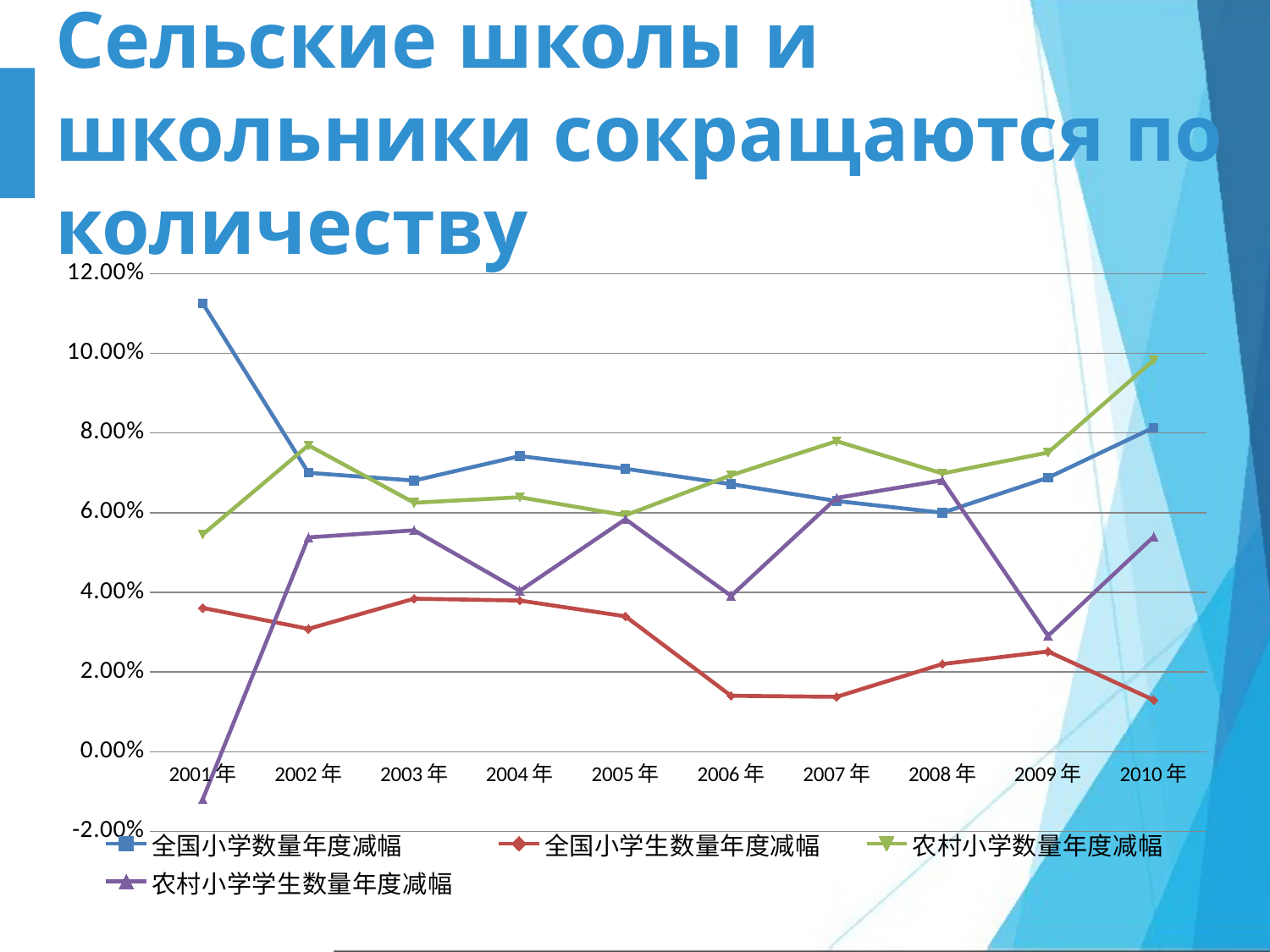
Which series has the highest value in 2001年? 全国小学数量年度减幅 In which year does the 农村小学学生数量年度减幅 series have its lowest value? 2001年 In which year does the 农村小学数量年度减幅 series reach its highest value? 2010年 How many years are plotted along the x axis of the chart? 10 In 2010年, which is larger: 农村小学数量年度减幅 or 全国小学数量年度减幅? 农村小学数量年度减幅 Does the 全国小学生数量年度减幅 series overall rise or fall from 2001年 to 2010年? fall How many series does the chart's legend list? 4 Is the value for 农村小学数量年度减幅 in 2010年 greater or less than 8.00%? greater What kind of chart is shown on the slide? line chart Is the value for 农村小学学生数量年度减幅 in 2001年 greater or less than 0.00%? less Is the value for 全国小学数量年度减幅 in 2001年 greater or less than 10.00%? greater